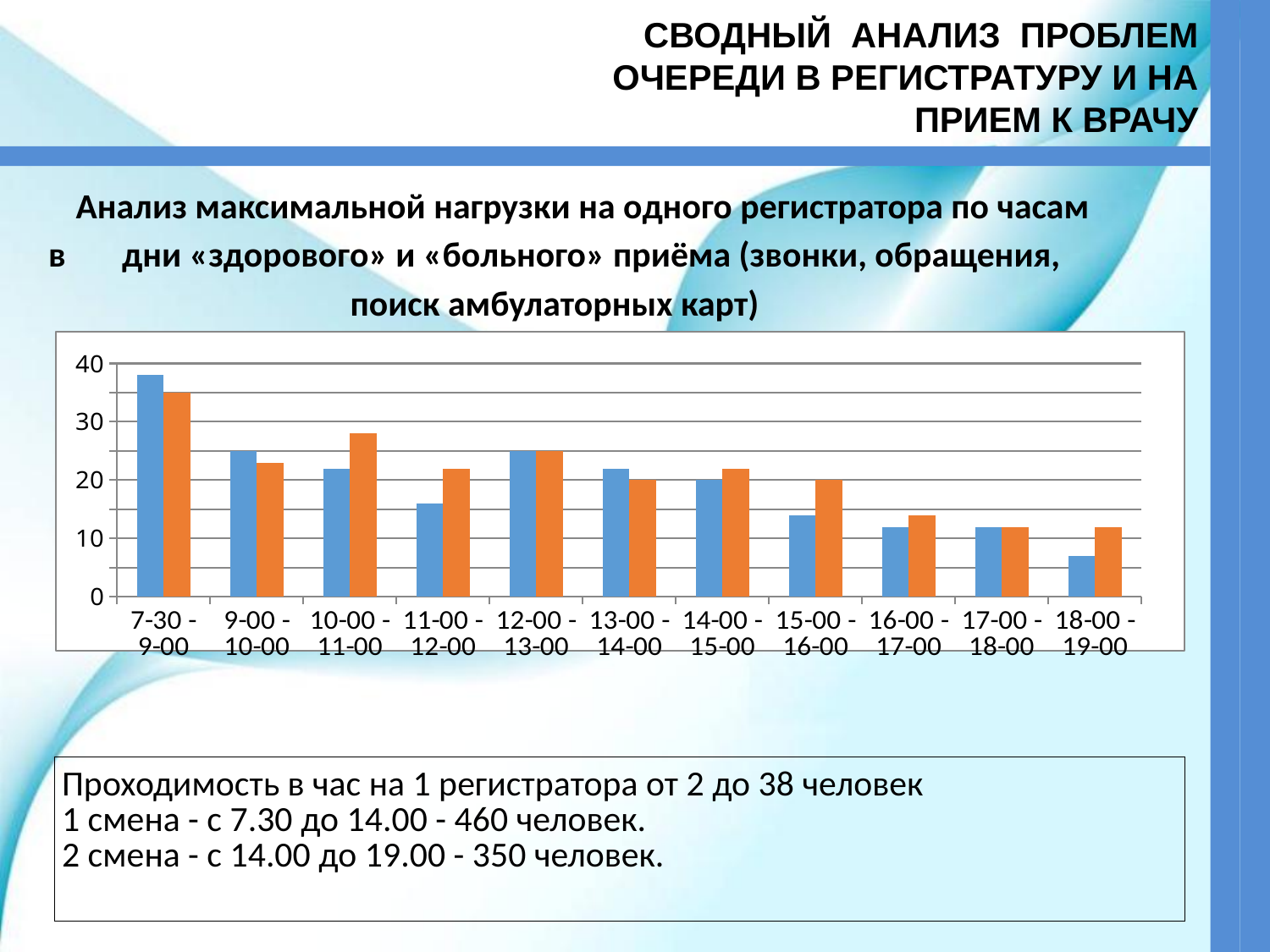
In which time slot is the blue bar the lowest? 18-00 - 19-00 In which time slot is the blue bar the highest? 7-30 - 9-00 For the 10-00 - 11-00 slot, which bar is taller, the blue one or the orange one? orange Is the orange bar for 10-00 - 11-00 greater or less than 20? greater Is the blue bar for 7-30 - 9-00 greater or less than 30? greater Is the blue bar for 11-00 - 12-00 greater or less than 20? less How many time-slot categories are shown on the x axis of the chart? 11 For the 15-00 - 16-00 slot, which bar is taller, the blue one or the orange one? orange In which time slot is the orange bar the highest? 7-30 - 9-00 Do the blue bars generally rise or fall from the first time slot to the last? fall What kind of chart is shown on the slide? bar chart